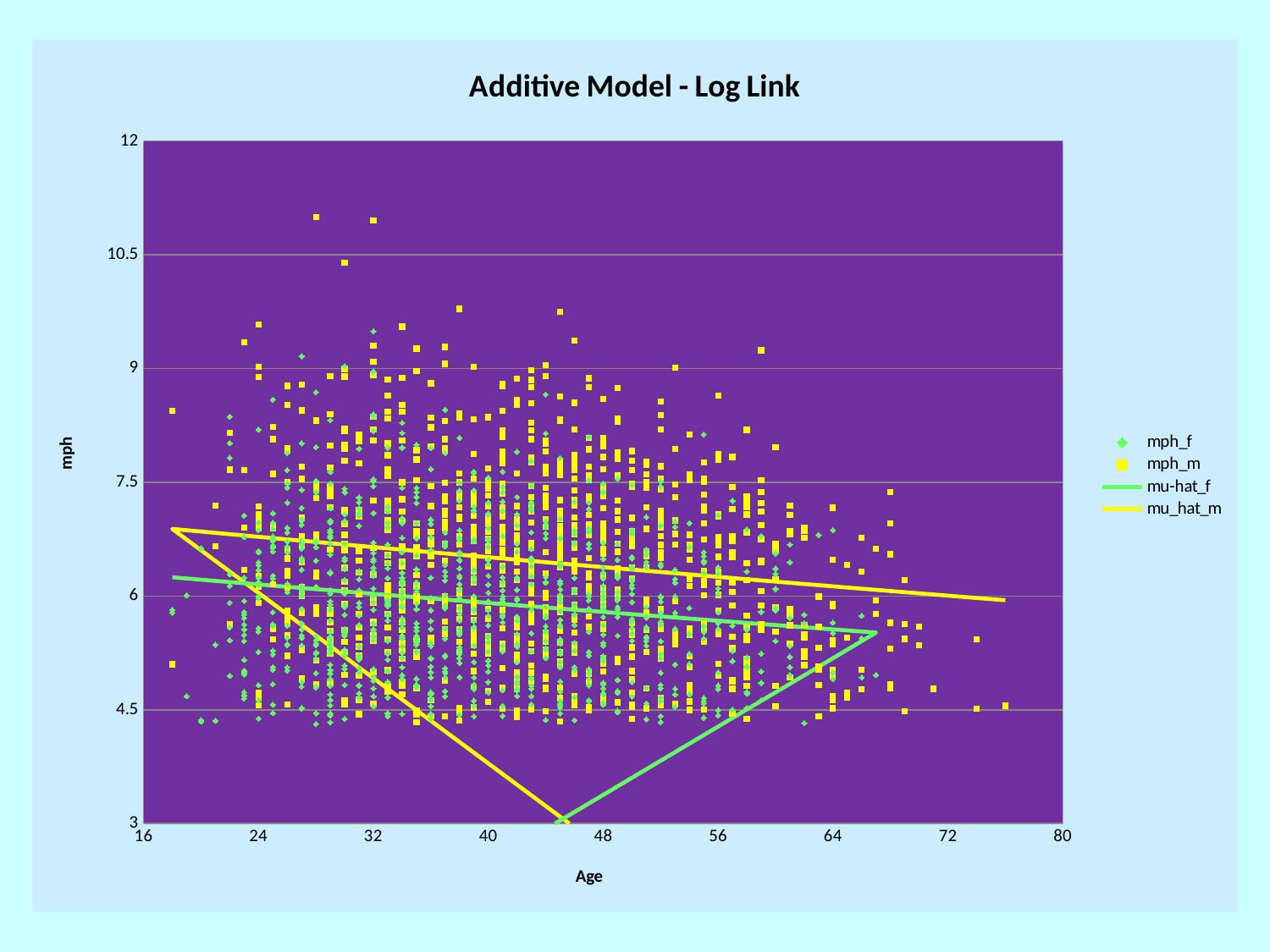
What is the title of the chart? Additive Model - Log Link Is the value of the mu_hat_m line at Age 72 greater or less than 7.5? less At Age 40, which line is higher, mu_hat_m or mu-hat_f? mu_hat_m Is the value of the mu-hat_f line at Age 56 greater or less than 6? less Does the mu_hat_m line rise or fall as Age increases? fall What is the label of the vertical axis? mph Which series is plotted with yellow square markers? mph_m Is the highest mph_m point greater or less than 10.5? greater What kind of chart is shown on the slide? scatter chart How many series does the legend list? 4 Does the mu-hat_f line rise or fall as Age increases? fall